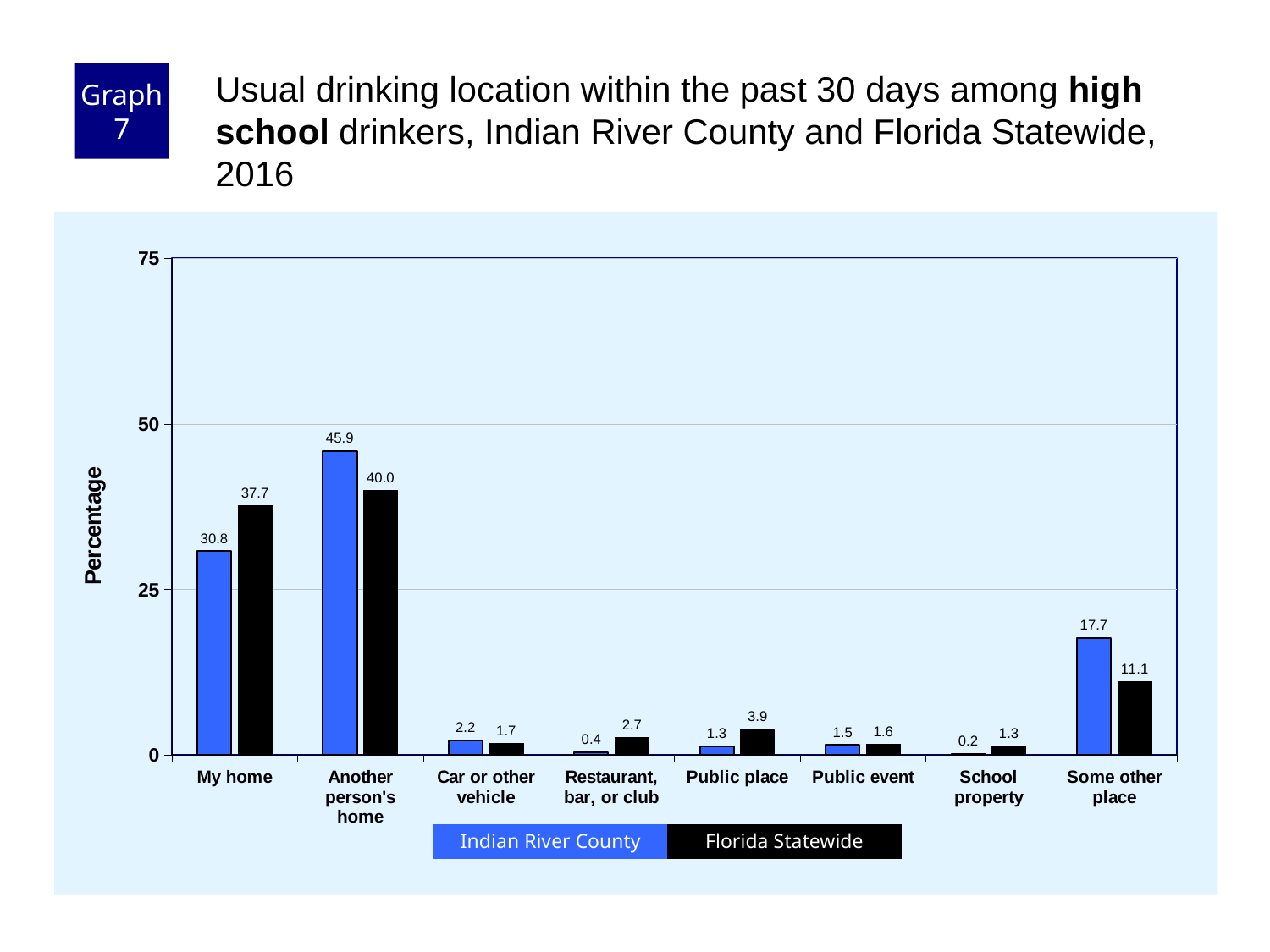
What is the label of the y axis? Percentage How many categories are shown on the x axis? 8 How many series does the legend list? 2 Which category has the highest Florida Statewide value? Another person's home What is the Indian River County value for "Another person's home"? 45.9 What is the Florida Statewide value for "My home"? 37.7 Which is larger for "Public place": the Indian River County value or the Florida Statewide value? Florida Statewide Is the Indian River County value for "My home" greater or less than 25? greater What kind of chart is shown on the slide? Bar chart Which category has the lowest Indian River County value? School property What is the Indian River County value for "Some other place"? 17.7 What is the difference between the Indian River County and Florida Statewide values for "Some other place"? 6.6